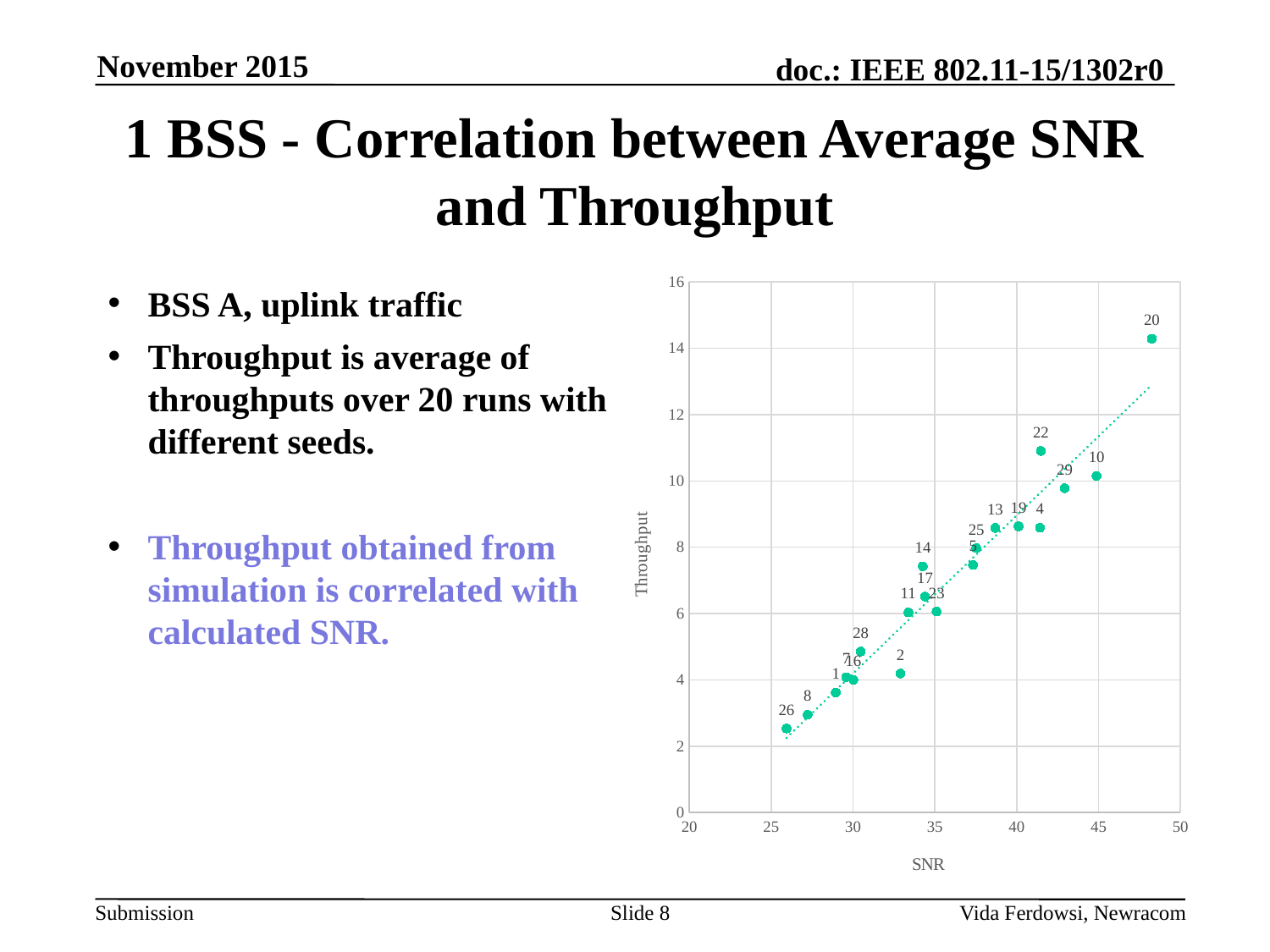
Is the throughput for point 26 greater or less than 4? less What is the label of the vertical axis of the chart? Throughput Is the throughput for point 20 greater or less than 12? greater Does throughput generally rise or fall as SNR increases? rise Is the throughput for point 22 greater or less than 10? greater What kind of chart is shown on the slide? scatter chart Which has the higher throughput, point 14 or point 11? 14 Which labelled point has the highest throughput? 20 Which labelled point has the lowest throughput? 26 What is the label of the horizontal axis of the chart? SNR Which has the higher throughput, point 22 or point 29? 22